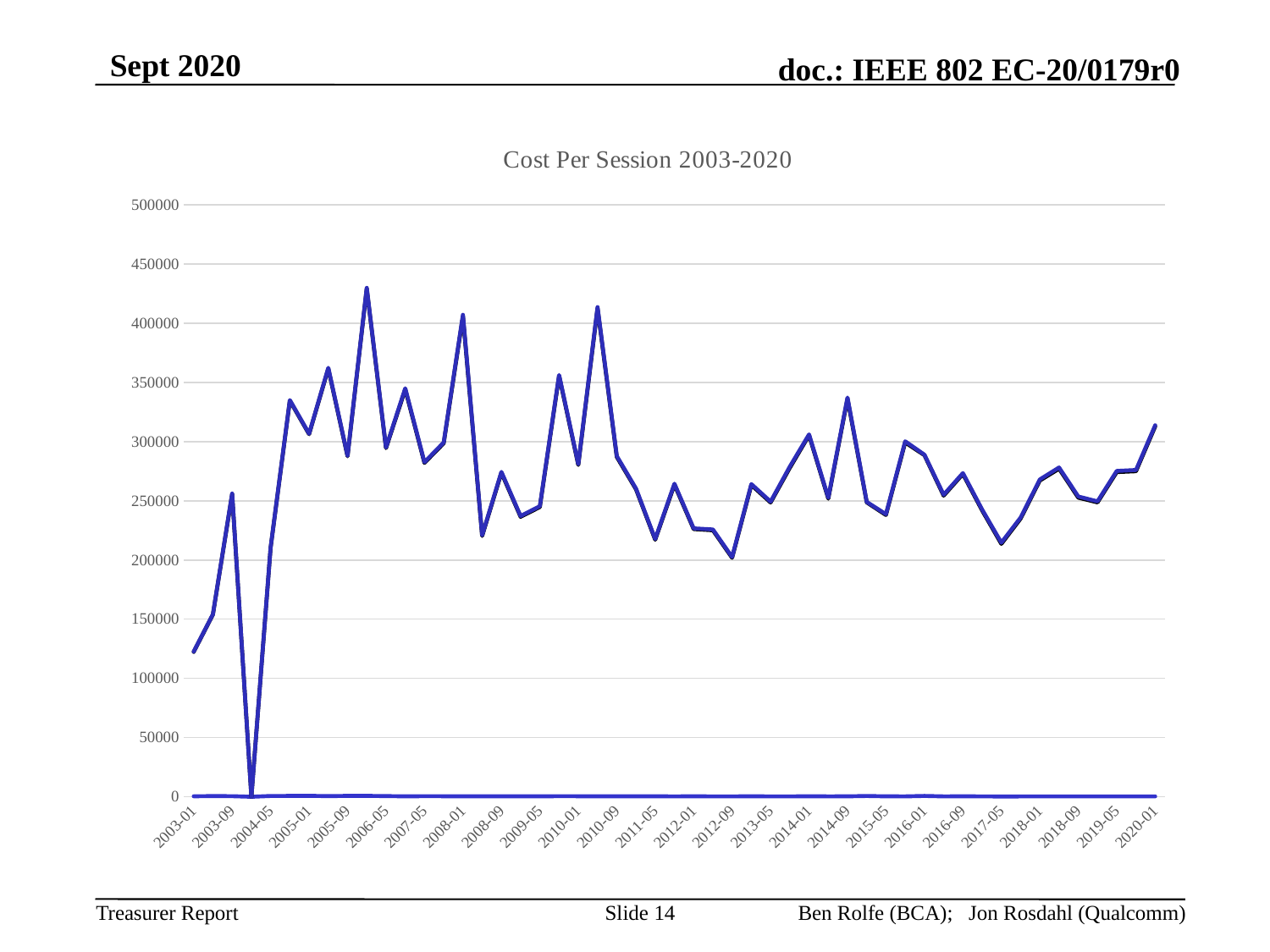
Does the line ever reach 500000? no Is the value for 2003-01 greater or less than 100000? greater What is the highest value shown on the y axis? 500000 Is the value for 2020-01 greater or less than 300000? greater How many labels are shown on the x axis? 26 What is the title of the chart? Cost Per Session 2003-2020 Which has the larger value, 2003-01 or 2020-01? 2020-01 What kind of chart is shown on the slide? line chart Does the line rise or fall between 2003-01 and 2003-09? rise